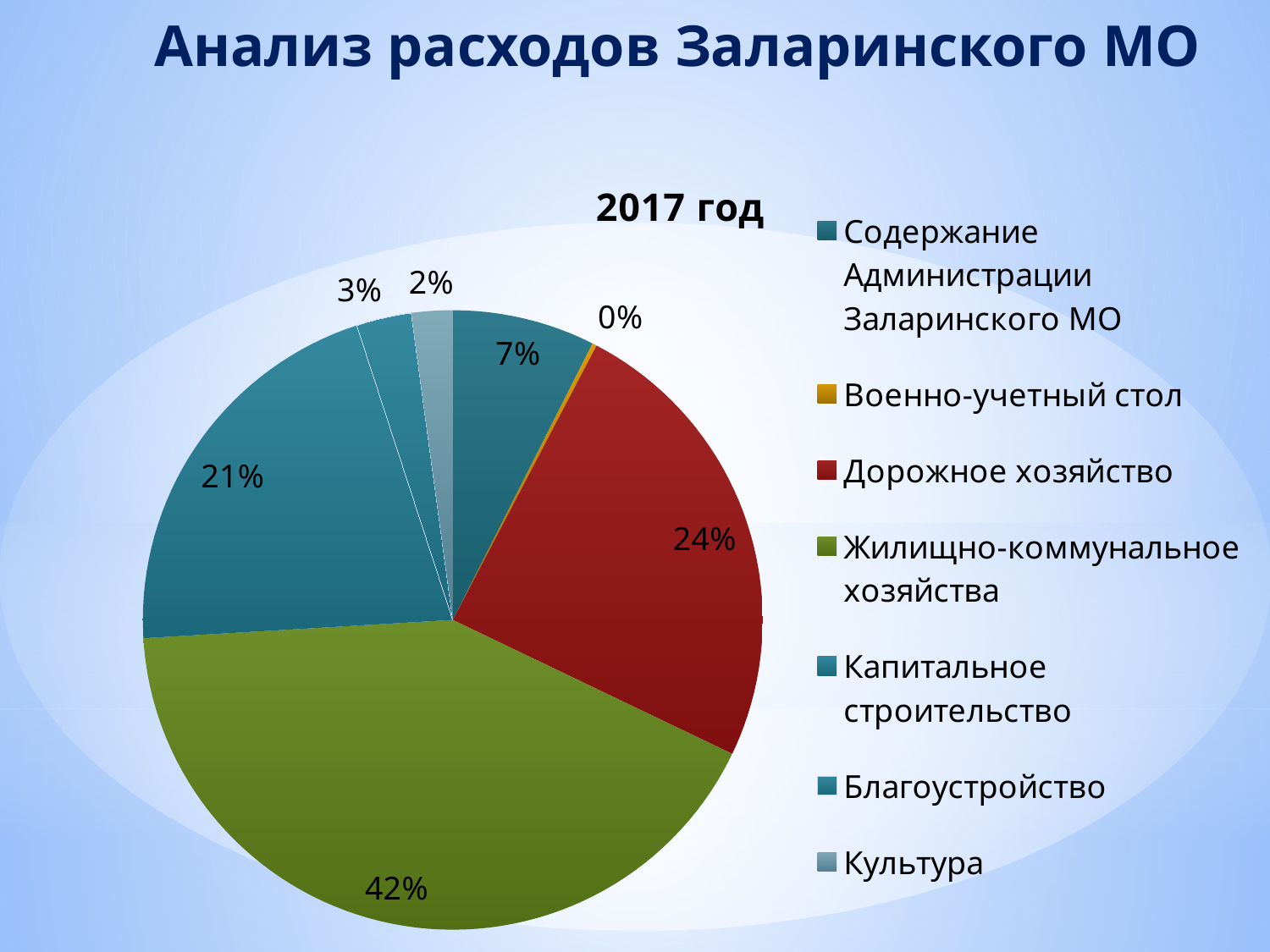
What share of expenses goes to Культура? 2% What is the title of the chart? 2017 год How many categories does the legend list? 7 Which category has the smallest share of expenses? Военно-учетный стол What share of expenses goes to Капитальное строительство? 21% What share of expenses goes to Жилищно-коммунальное хозяйства? 42% Which has a larger share: Капитальное строительство or Благоустройство? Капитальное строительство What kind of chart is shown on the slide? Pie chart What is the difference in percentage points between Жилищно-коммунальное хозяйства and Дорожное хозяйство? 18 percentage points Which category has the largest share of expenses? Жилищно-коммунальное хозяйства